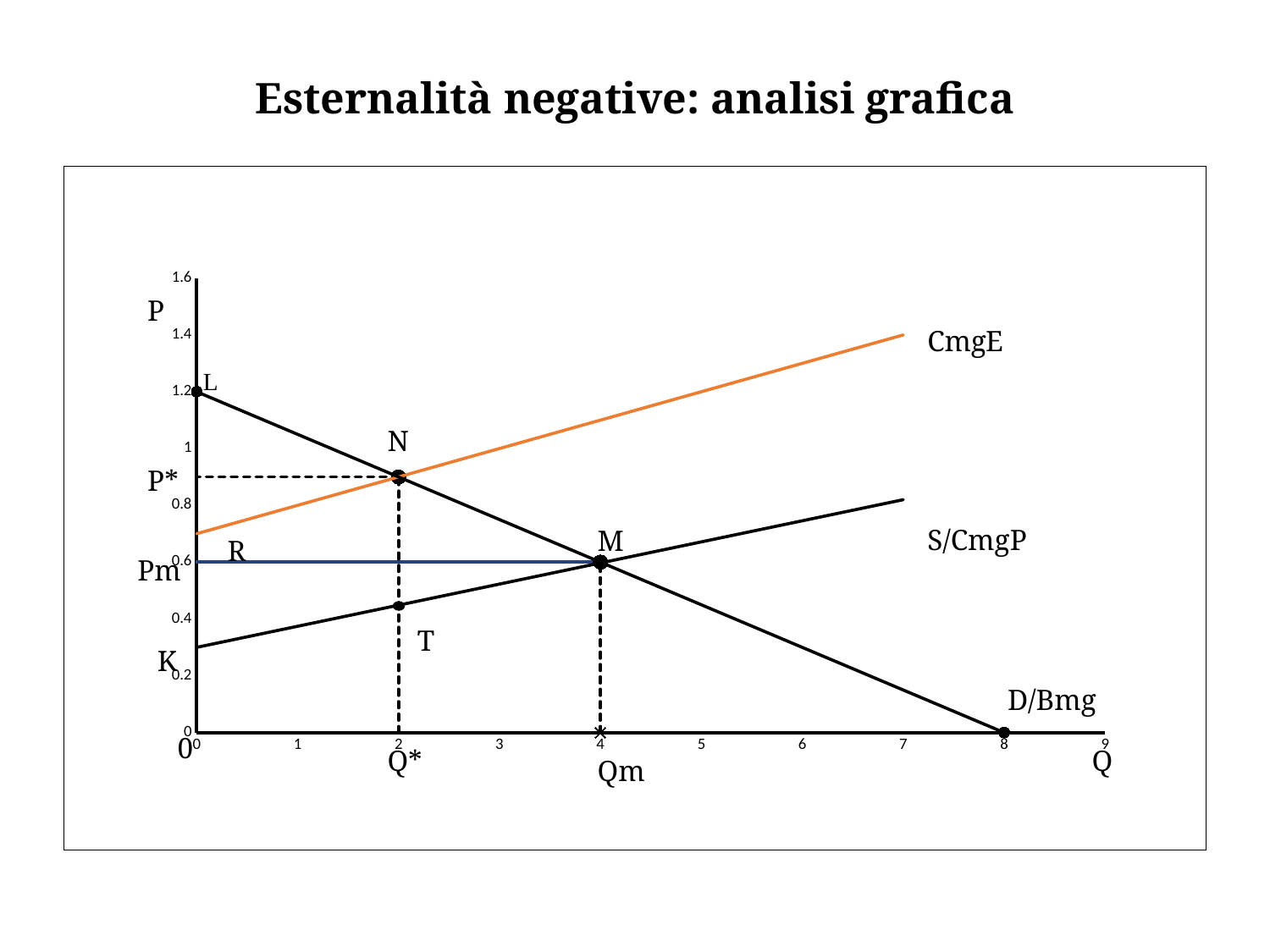
Does the D/Bmg line rise or fall as Q increases? fall What is the value of Q at Qm? 4 At Q = 2, which point is higher, N or T? N What kind of chart is shown on the slide? line chart Is the value of P* (at point N) greater or less than 0.8? greater Is the value of P at point T greater or less than 0.6? less What is the value of P at point L, where the D/Bmg line meets the vertical axis? 1.2 Is the value of the CmgE line at Q = 7 greater or less than 1.2? greater What colour is the CmgE line? orange At what value of Q does the D/Bmg line meet the horizontal axis? 8 What is the value of Q at Q*? 2 What is the value of P at point M (Pm)? 0.6